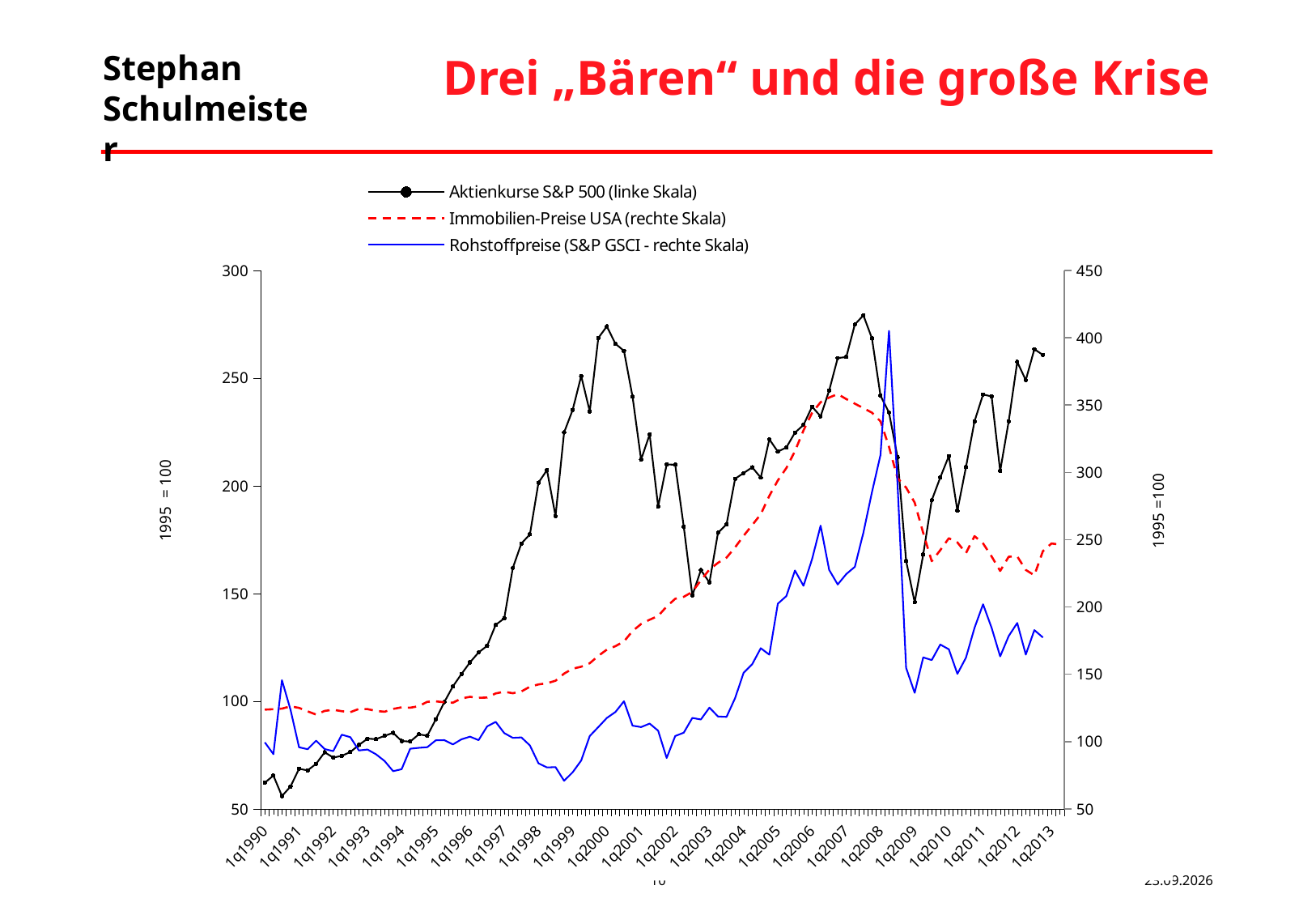
Which is larger for Aktienkurse S&P 500: the value at 1q2000 or the value at 1q2003? 1q2000 Is the value of Aktienkurse S&P 500 at 1q2009 greater or less than 200? less Is the value of Immobilien-Preise USA at 1q2007 greater or less than 300 on the right scale? greater How many series does the legend list? 3 What is the title of the slide containing the chart? Drei „Bären“ und die große Krise Is the value of Aktienkurse S&P 500 at 1q1990 greater or less than 100? less Which series is plotted against the left scale according to the legend? Aktienkurse S&P 500 What kind of chart is shown on the slide? line chart Does the Immobilien-Preise USA series rise or fall between 1q2007 and 1q2009? fall Does the Aktienkurse S&P 500 series rise or fall between 1q1995 and 1q2000? rise